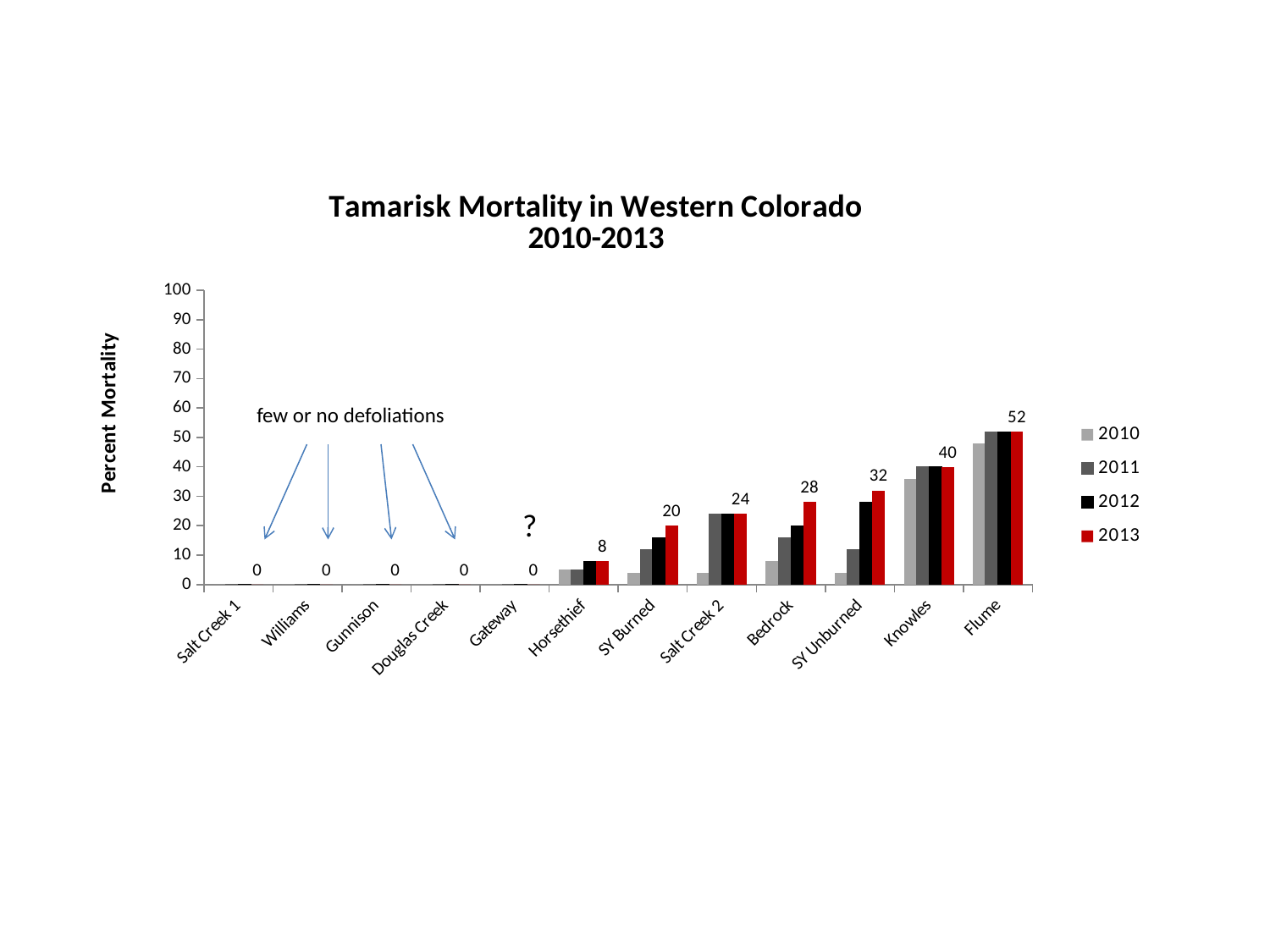
What is the 2013 percent mortality for Flume? 52 Which site has the larger 2013 percent mortality, SY Burned or Salt Creek 2? Salt Creek 2 What is the difference between the 2013 percent mortality for Flume and for Knowles? 12 What is the title of the y axis? Percent Mortality What is the 2013 percent mortality for Bedrock? 28 How many sites are shown on the x axis? 12 How many series does the legend list? 4 Is the 2010 percent mortality for Flume greater or less than 40? greater What is the 2013 percent mortality for Knowles? 40 What kind of chart is shown on the slide? bar chart Do the 2013 percent mortality values rise or fall from left to right along the x axis? rise Which site has the highest 2013 percent mortality? Flume